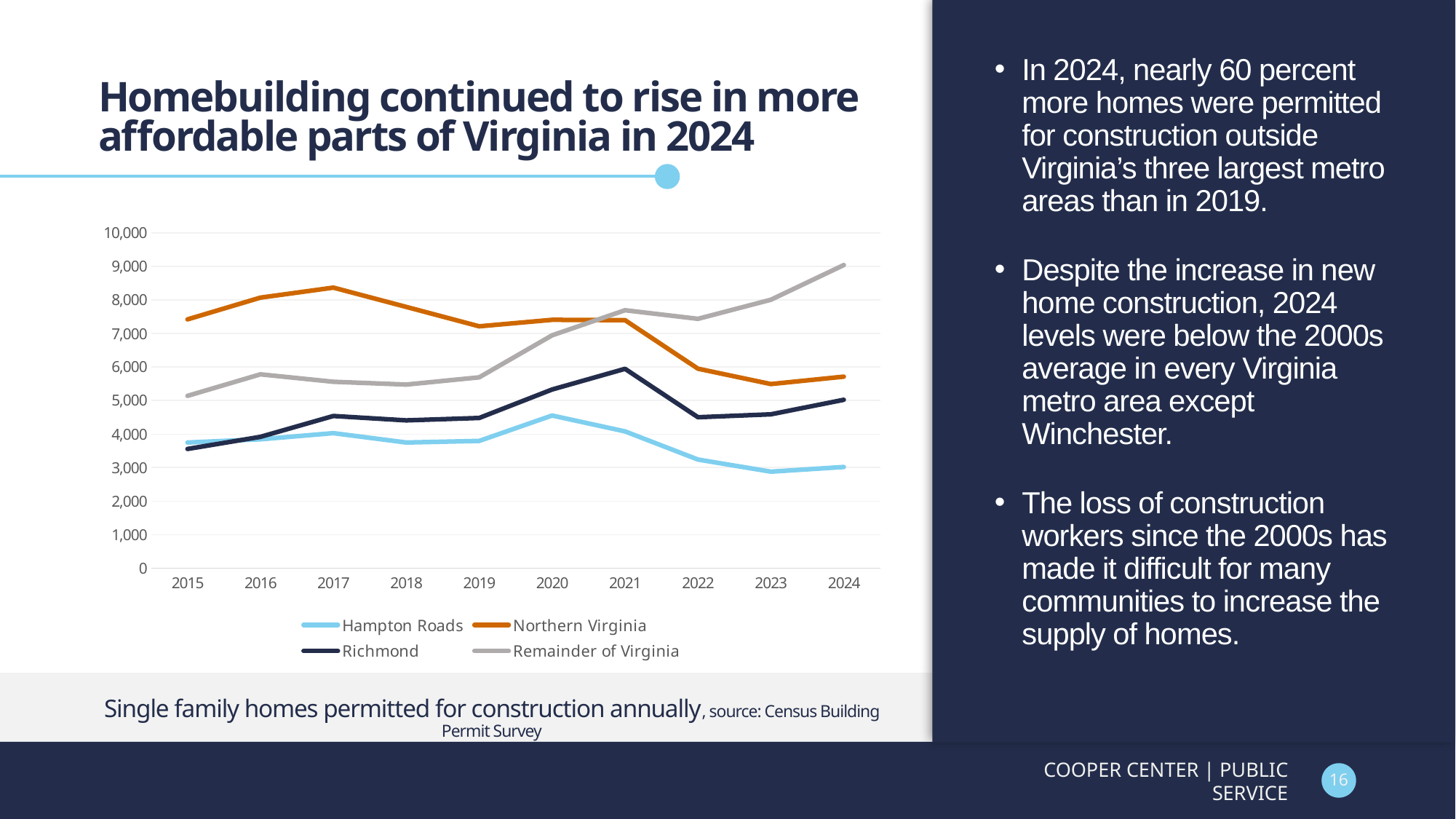
Is the value for Northern Virginia in 2017 greater or less than 8,000? greater How many series does the chart's legend list? 4 Does the Remainder of Virginia line rise or fall from 2022 to 2024? rise Which series has the lowest value in 2024? Hampton Roads What kind of chart is shown on the slide? line chart How many years are shown along the x axis of the chart? 10 In 2024, which is larger: the value for Richmond or the value for Hampton Roads? Richmond What colour is the Northern Virginia line in the chart? orange Which series has the highest value in 2017? Northern Virginia Is the value for Hampton Roads in 2023 greater or less than 3,000? less Is the value for Remainder of Virginia in 2024 greater or less than 8,000? greater Which series has the highest value in 2024? Remainder of Virginia